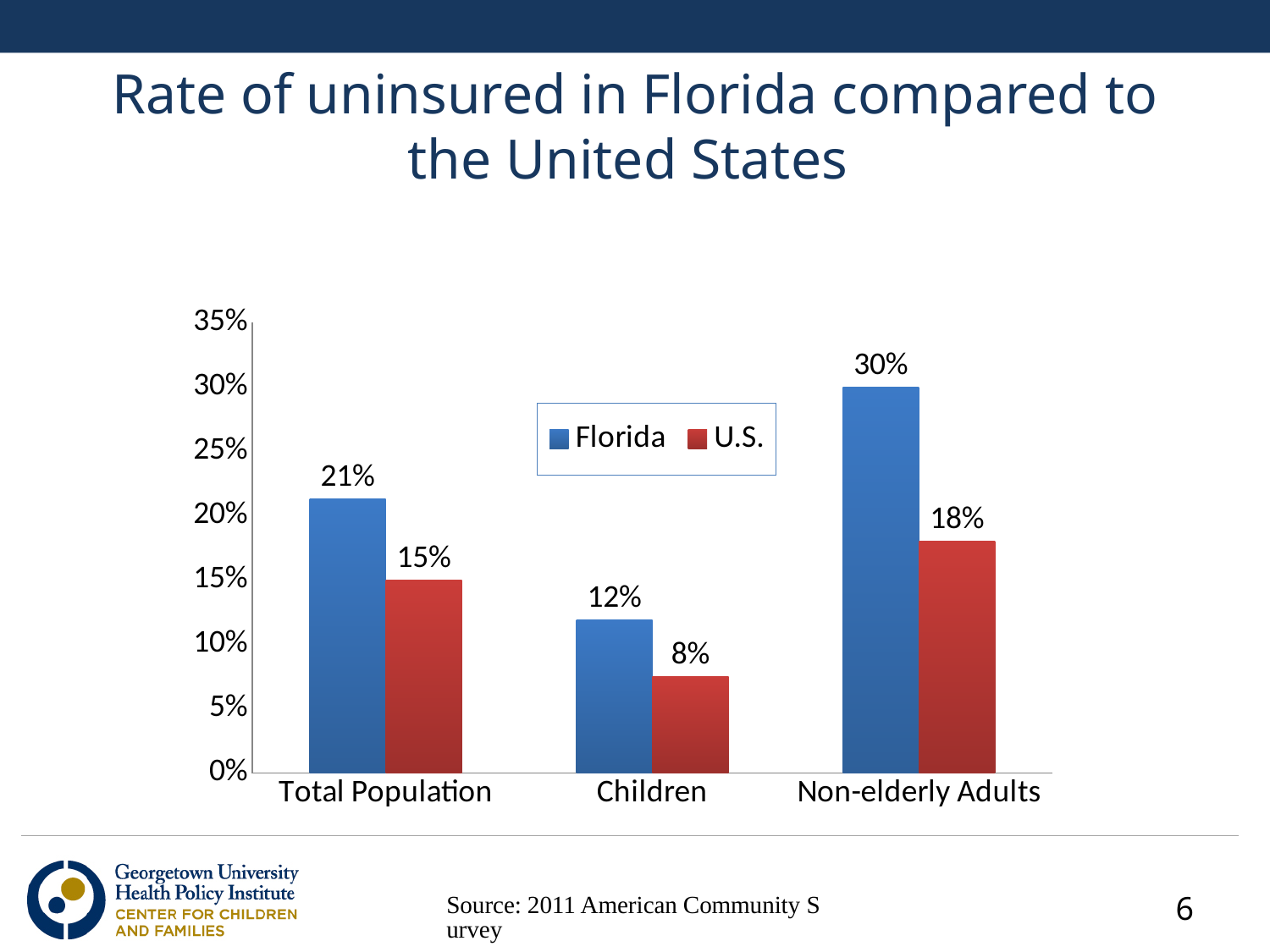
Which category has the lowest uninsured rate for the U.S.? Children What is the difference between the Florida and U.S. uninsured rates for Non-elderly Adults? 12% How many categories are shown on the x axis? 3 What is the uninsured rate for the U.S. among Children? 8% Which is larger, the Florida uninsured rate for Children or the U.S. uninsured rate for Children? Florida What is the uninsured rate for the U.S. in the Total Population category? 15% Which category has the highest uninsured rate for Florida? Non-elderly Adults What colour are the bars for the U.S. series? Red What kind of chart is shown on the slide? Bar chart What is the uninsured rate for Florida in the Total Population category? 21% What is the uninsured rate for Florida among Non-elderly Adults? 30% How many series does the legend list? 2